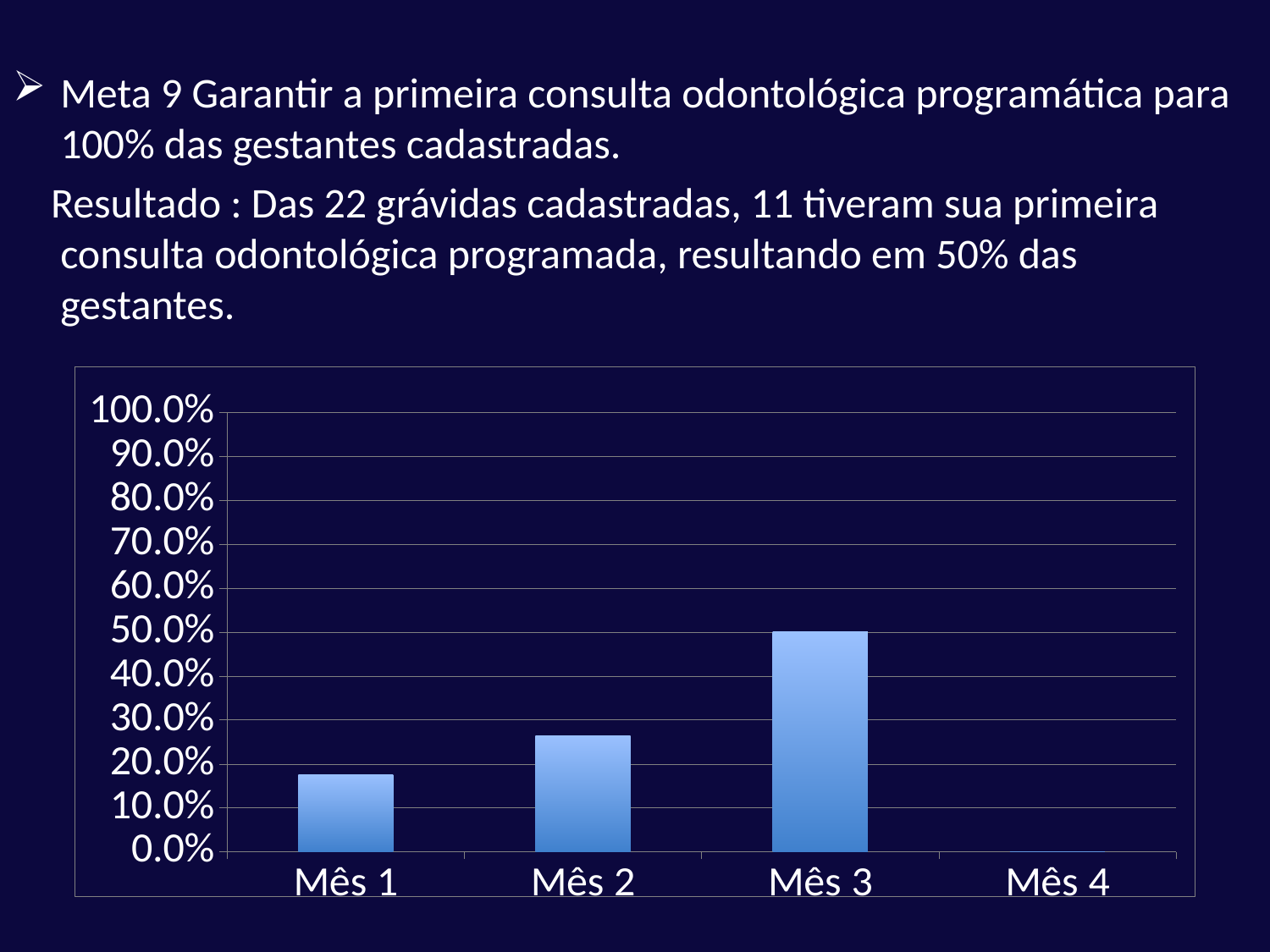
Which month has the highest bar in the chart? Mês 3 How many categories are shown on the x axis of the chart? 4 Which month has the lowest bar in the chart? Mês 4 What is the value for Mês 3 in the chart? 50.0% Which is larger, the value for Mês 1 or the value for Mês 2? Mês 2 What is the value for Mês 4 in the chart? 0.0% Is the value for Mês 2 greater or less than 20.0%? greater What kind of chart is shown on the slide? bar chart What is the highest value shown on the y axis of the chart? 100.0% Is the value for Mês 2 greater or less than 30.0%? less Do the values rise or fall from Mês 1 to Mês 3? rise Is the value for Mês 1 greater or less than 20.0%? less